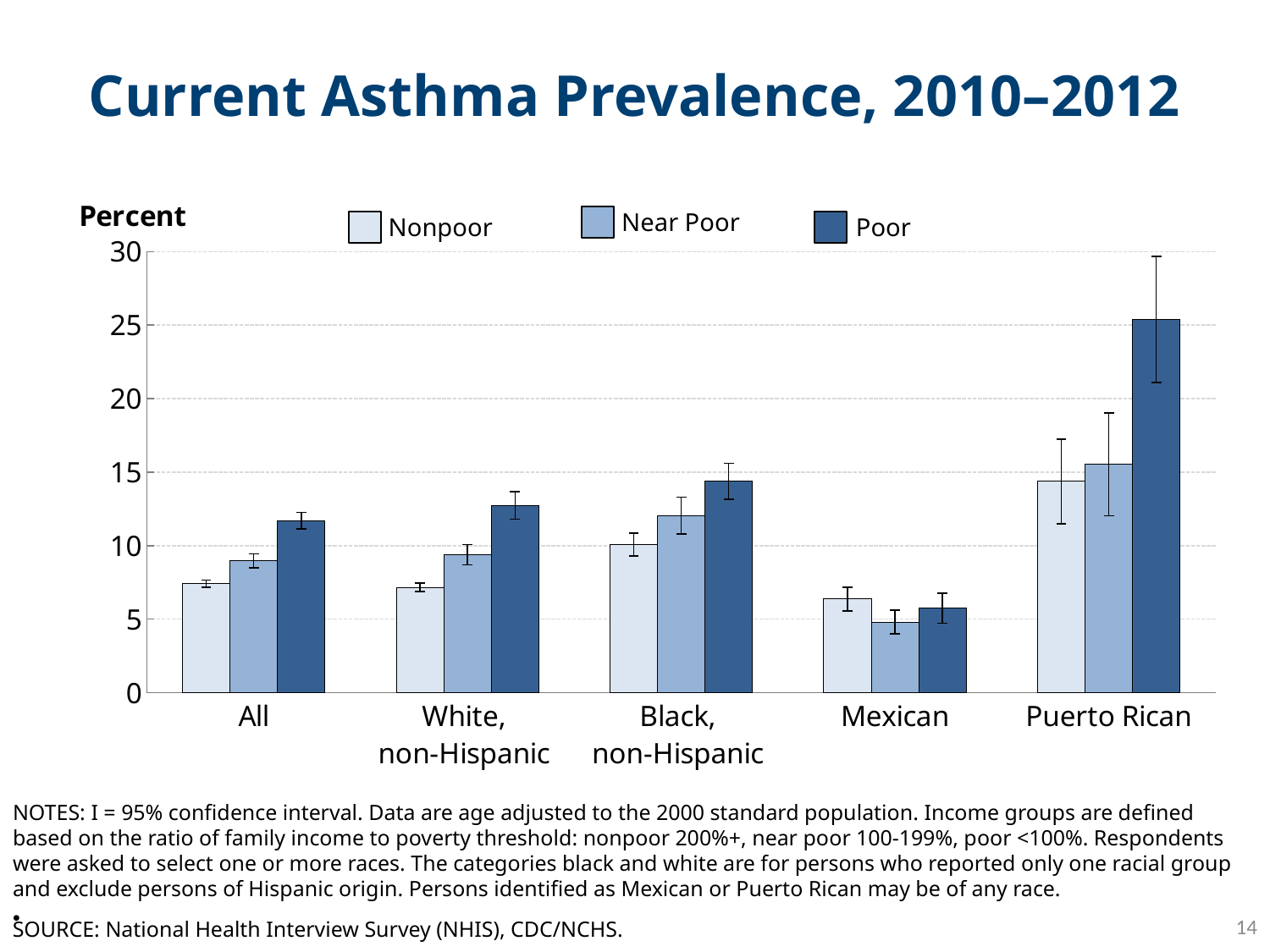
For the Mexican category, which is larger: the Nonpoor value or the Near Poor value? Nonpoor Is the Near Poor value for Black, non-Hispanic greater or less than 10? greater Which category has the lowest value for the Near Poor series? Mexican What is the label on the vertical axis? Percent What is the title of the chart? Current Asthma Prevalence, 2010–2012 How many series does the legend list? 3 Is the Poor value for Puerto Rican greater or less than 20? greater Is the Nonpoor value for All greater or less than 10? less Which is larger: the Poor value for Black, non-Hispanic or the Poor value for Mexican? Black, non-Hispanic Which category has the highest value for the Poor series? Puerto Rican How many categories are shown along the x axis? 5 What kind of chart is shown on the slide? Bar chart